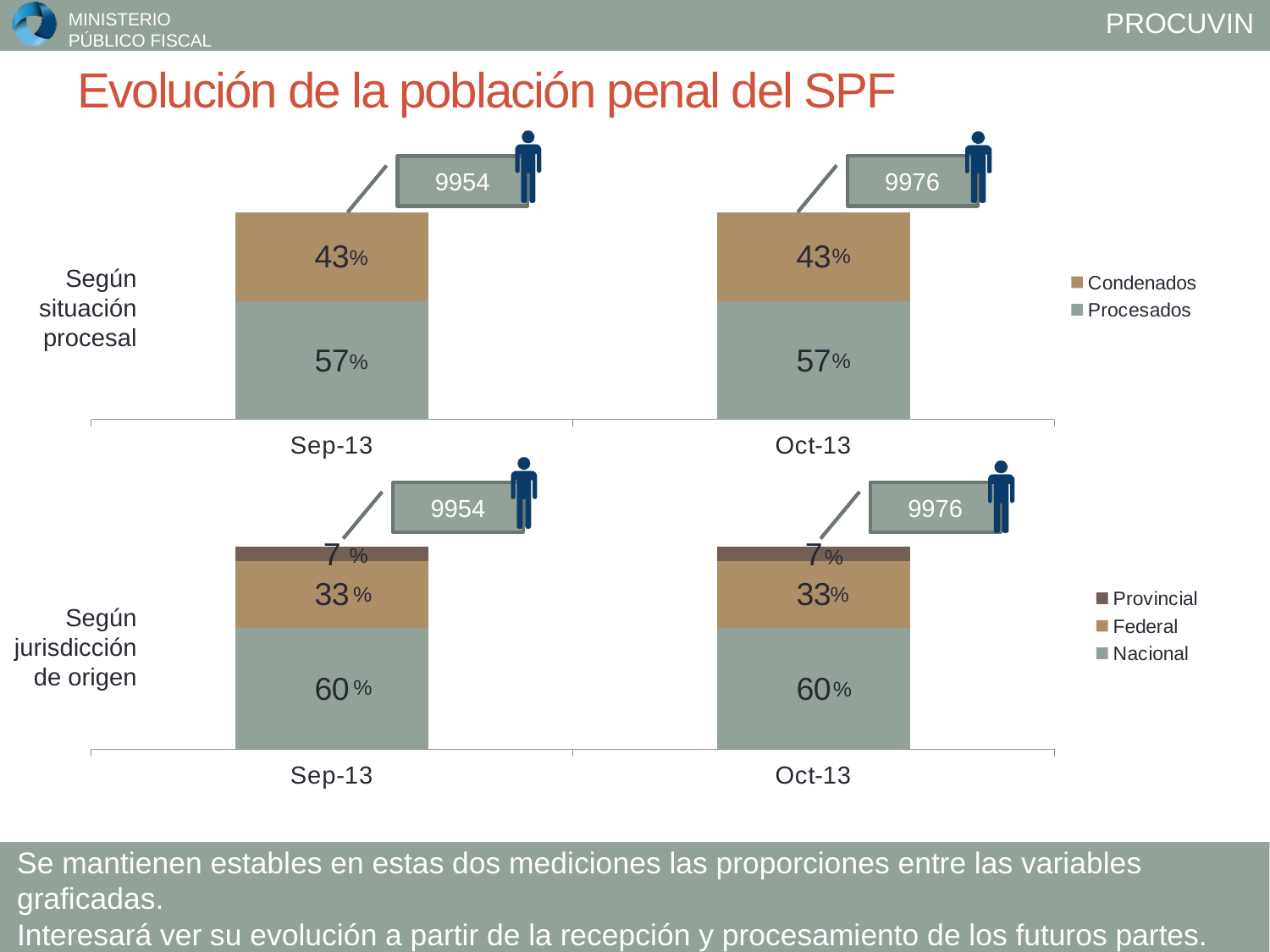
How many time periods are shown on the x axis of the top chart (Según situación procesal)? 2 In the bottom chart (Según jurisdicción de origen), which jurisdiction has the largest share in Oct-13? Nacional In the top chart (Según situación procesal), what is the difference in percentage points between Procesados and Condenados in Sep-13? 14 In the top chart (Según situación procesal), which is larger in Oct-13, Condenados or Procesados? Procesados How many series does the legend of the bottom chart (Según jurisdicción de origen) list? 3 What total population figure is shown in the callout above the Oct-13 bar in the top chart (Según situación procesal)? 9976 What kind of chart is the top chart (Según situación procesal)? Stacked bar chart In the bottom chart (Según jurisdicción de origen), which jurisdiction has the smallest share in Sep-13? Provincial In the top chart (Según situación procesal), what percentage of the Oct-13 bar is Condenados? 43% In the bottom chart (Según jurisdicción de origen), what percentage of the Oct-13 bar is Federal? 33% In the bottom chart (Según jurisdicción de origen), what percentage of the Sep-13 bar is Provincial? 7% In the top chart (Según situación procesal), what percentage of the Sep-13 bar is Procesados? 57%